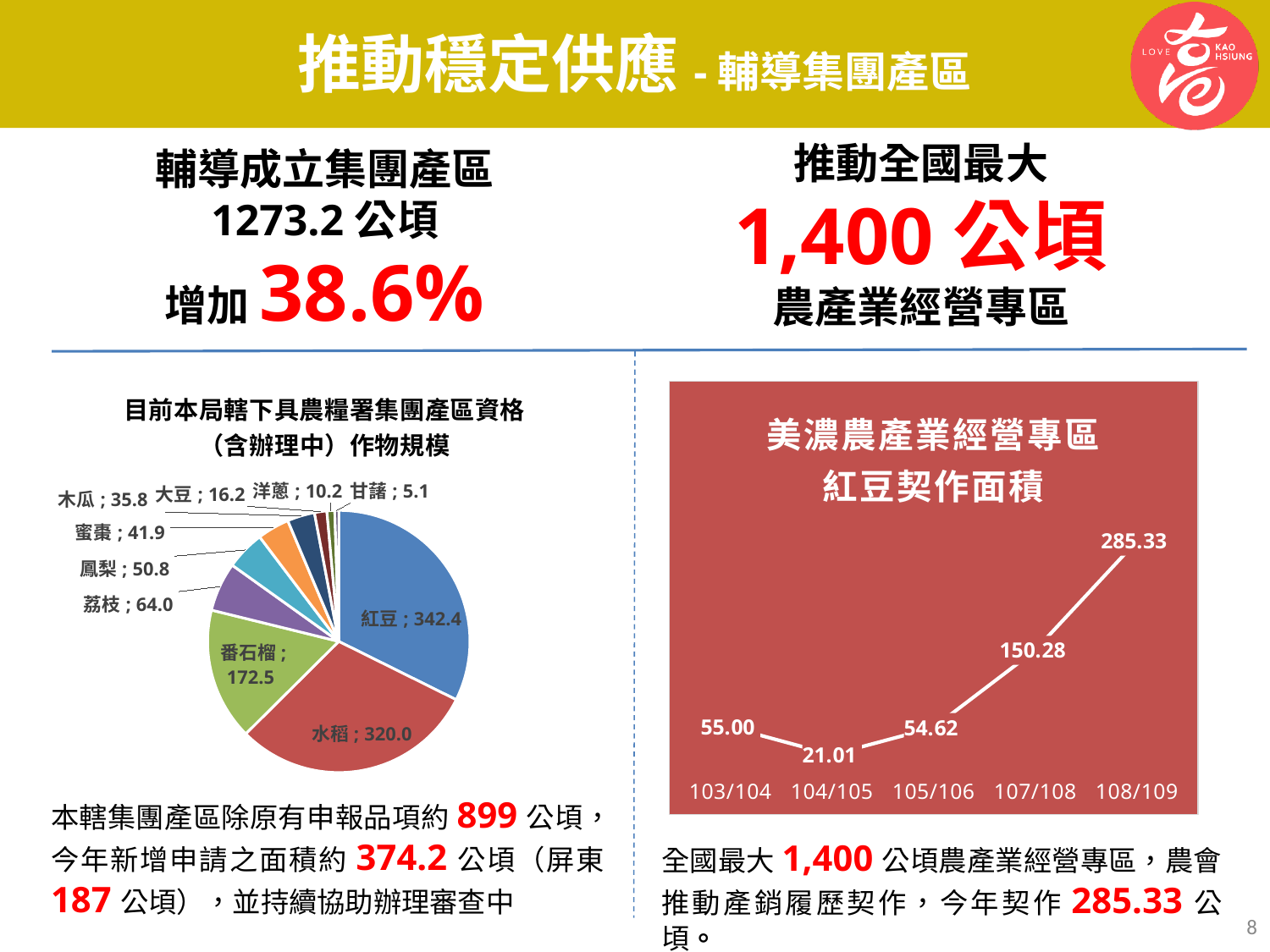
In the pie chart on the left, which crop has the smallest value? 甘藷 In the pie chart on the left, what is the value for 番石榴? 172.5 In the pie chart on the left, what is the difference between the values for 紅豆 and 水稻? 22.4 In the pie chart on the left, what is the value for 紅豆? 342.4 In the line chart 美濃農產業經營專區紅豆契作面積, what is the difference between the values for 108/109 and 107/108? 135.05 In the line chart 美濃農產業經營專區紅豆契作面積, which period has the lowest value? 104/105 In the pie chart on the left, how many crop categories are shown? 10 What type of chart is the right chart titled 美濃農產業經營專區紅豆契作面積? line chart In the pie chart on the left, which is larger, 荔枝 or 鳳梨? 荔枝 In the pie chart on the left, which crop has the largest value? 紅豆 What type of chart is the left chart titled 目前本局轄下具農糧署集團產區資格（含辦理中）作物規模? pie chart In the line chart 美濃農產業經營專區紅豆契作面積, what is the value for 107/108? 150.28